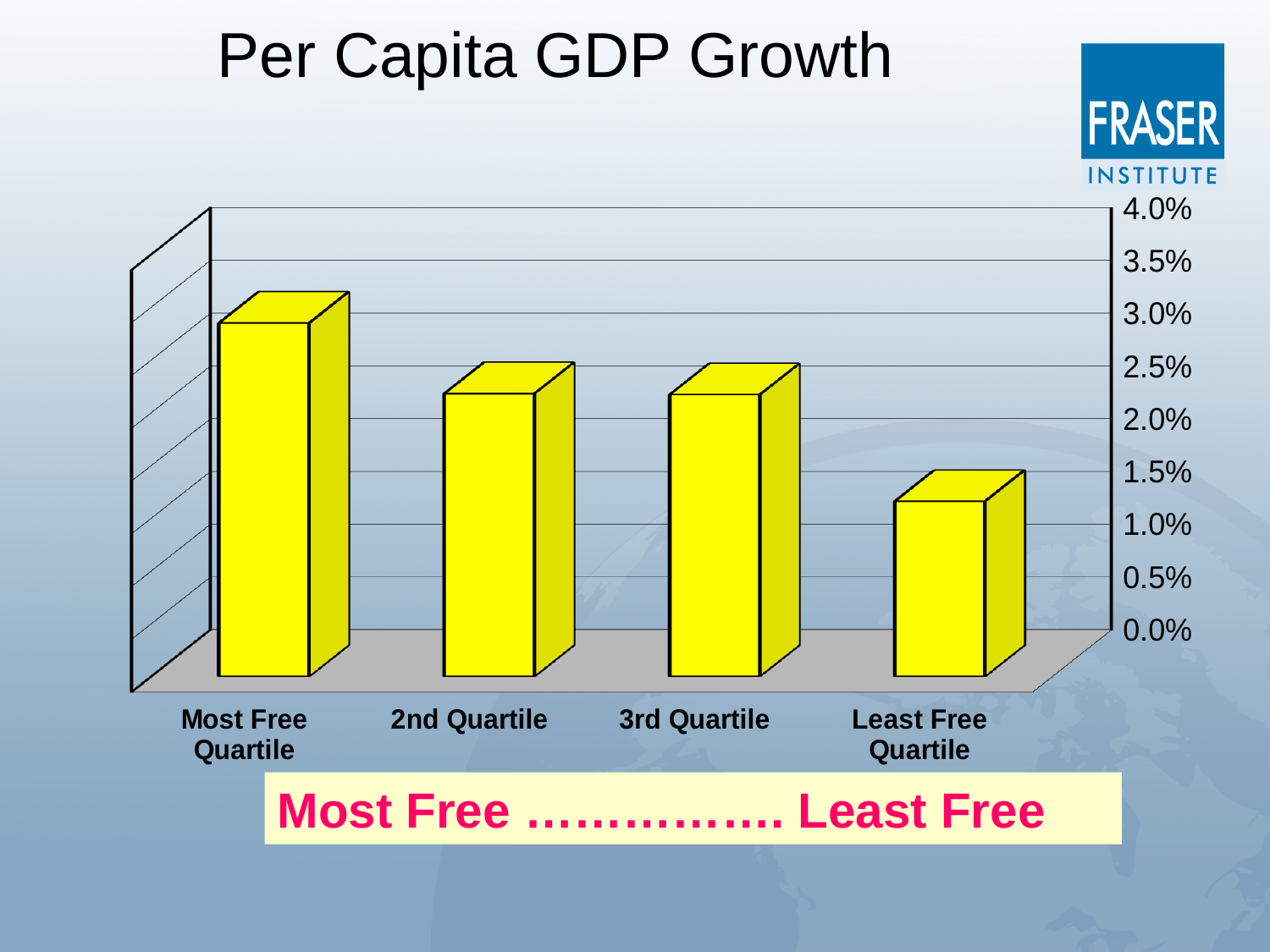
Which category has the highest per capita GDP growth? Most Free Quartile What is the title of the chart? Per Capita GDP Growth Which category has the lowest per capita GDP growth? Least Free Quartile Is the value for the 2nd Quartile greater or less than 2.0%? greater Do the values generally rise or fall moving from the Most Free Quartile to the Least Free Quartile? fall What kind of chart is shown on the slide? bar chart Which is larger, the value for the Most Free Quartile or the Least Free Quartile? Most Free Quartile What colour are the bars in the chart? yellow How many categories are plotted on the chart? 4 Is the value for the Most Free Quartile greater or less than 2.5%? greater